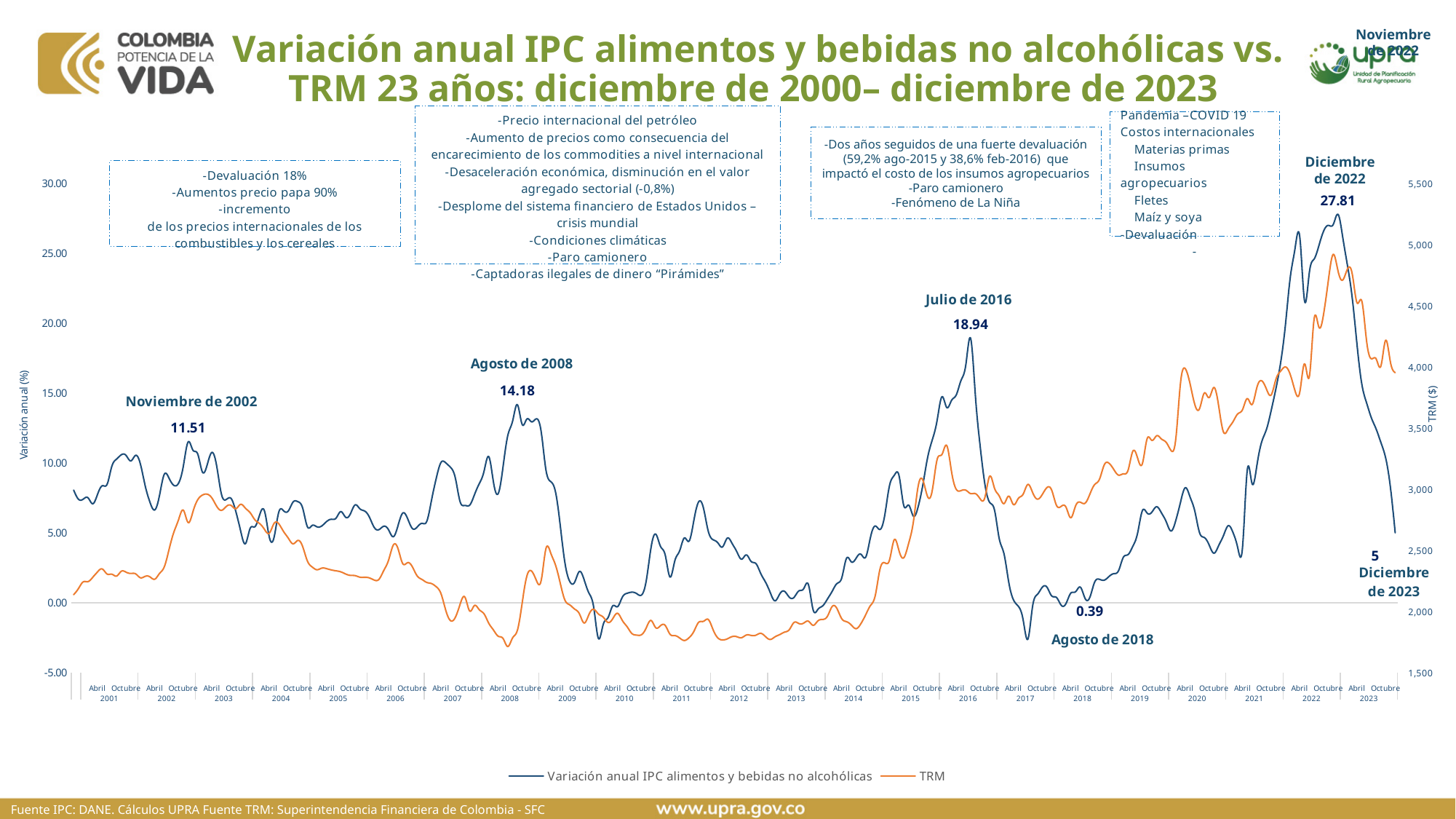
What is the labelled value of the annual food and non-alcoholic beverages IPC variation for Noviembre de 2002? 11.51 What value is labelled for Julio de 2016 on the IPC variation line? 18.94 How many series does the legend list? 2 What value is labelled for Agosto de 2018 on the IPC variation line? 0.39 What value is labelled for Agosto de 2008 on the IPC variation line? 14.18 Which labelled point on the IPC variation line has the highest value? Diciembre de 2022 What value is labelled for Diciembre de 2022 on the IPC variation line? 27.81 Which labelled point on the IPC variation line has the lowest value? Agosto de 2018 What kind of chart is shown on the slide? Line chart Which labelled value is larger: Julio de 2016 or Agosto de 2008? Julio de 2016 What is the difference between the labelled values for Diciembre de 2022 and Julio de 2016? 8.87 Is the peak TRM value reached in 2022 greater or less than 4,500? greater